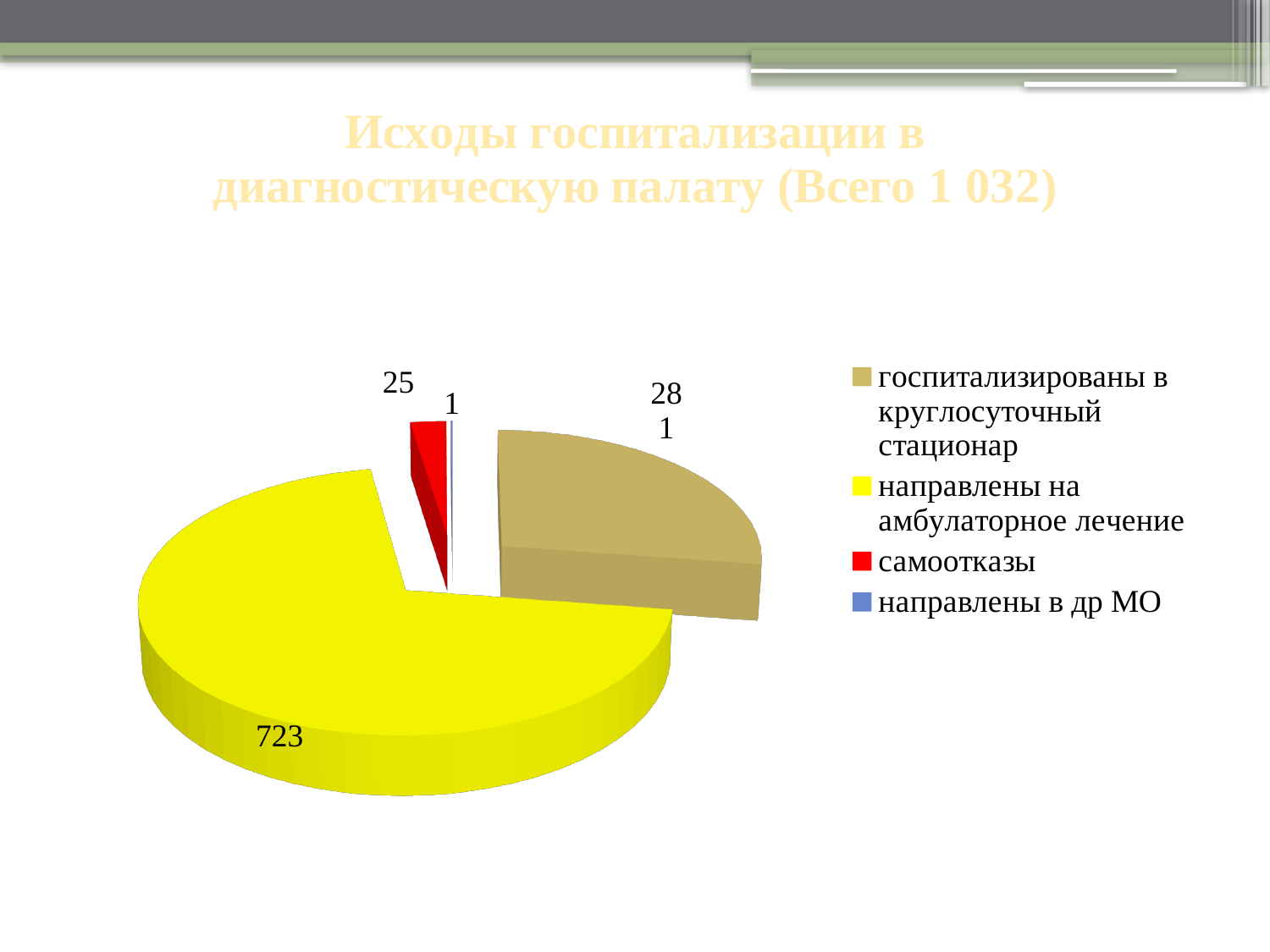
What is the value for 'самоотказы'? 25 Which is larger: the value for 'самоотказы' or the value for 'направлены в др МО'? самоотказы What colour is the slice for 'самоотказы'? red Which category has the largest slice in the pie chart? направлены на амбулаторное лечение What is the value for 'госпитализированы в круглосуточный стационар'? 281 What is the value for 'направлены на амбулаторное лечение'? 723 What is the difference between the value for 'направлены на амбулаторное лечение' and the value for 'самоотказы'? 698 What kind of chart is shown on the slide? pie chart How many slices does the pie chart have? 4 What total is given in the chart title? 1 032 Which category has the smallest slice in the pie chart? направлены в др МО What is the value for 'направлены в др МО'? 1